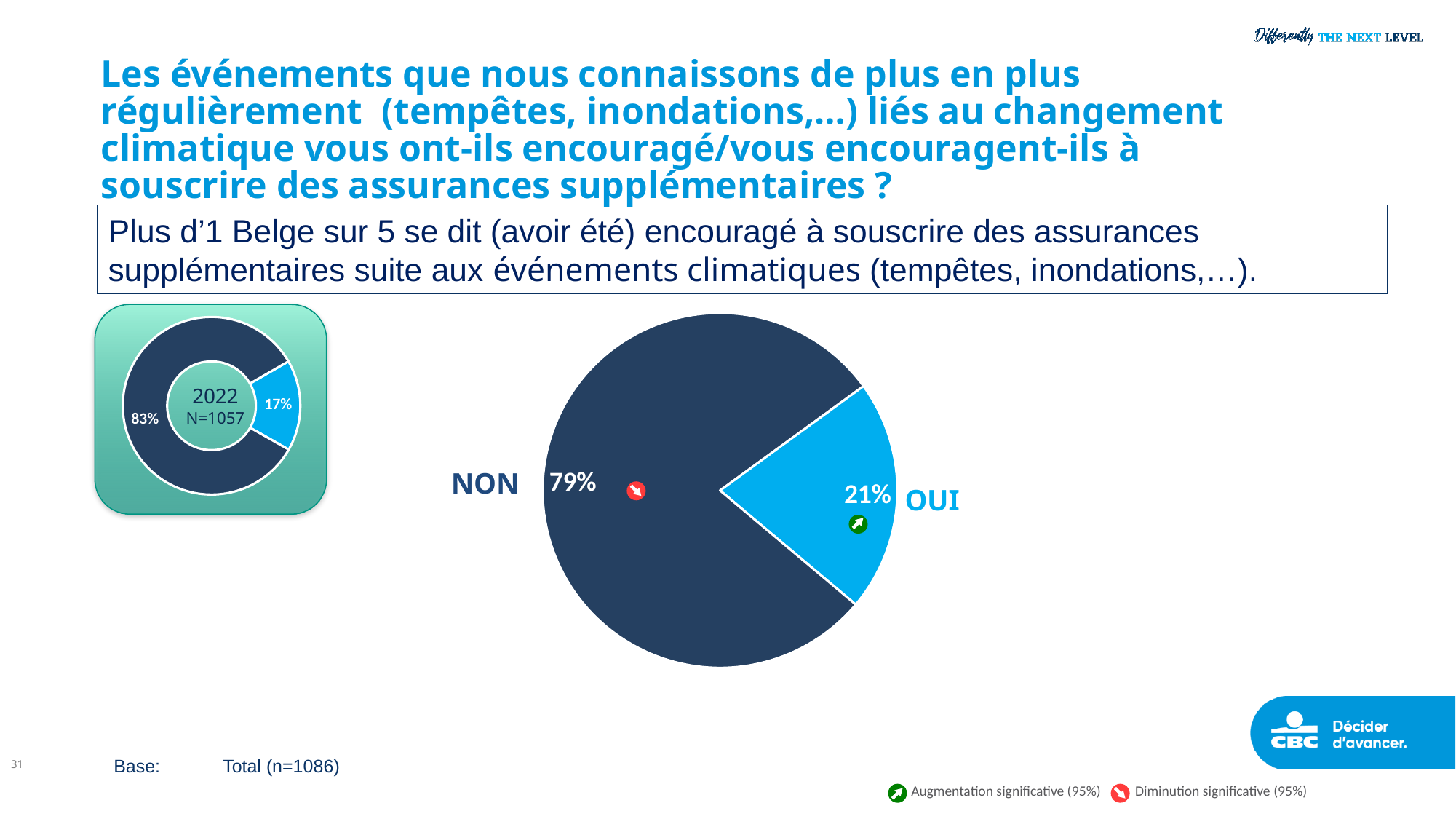
How many slices does the large pie chart have? 2 What kind of chart is the large chart in the centre of the slide? Pie chart In the small donut chart on the left, what percentage is shown for the light blue segment? 17% In the large pie chart, what is the difference in percentage points between NON and OUI? 58 What year and sample size are shown in the centre of the small donut chart on the left? 2022, N=1057 In the large pie chart, what percentage is shown for NON? 79% In the large pie chart, which category has the smallest slice? OUI In the small donut chart on the left, what percentage is shown for the dark blue segment? 83% In the large pie chart, which is larger, the OUI slice or the NON slice? NON In the large pie chart, what percentage is shown for OUI? 21% In the large pie chart, which category has the largest slice? NON In the large pie chart, what colour is the OUI slice? Light blue